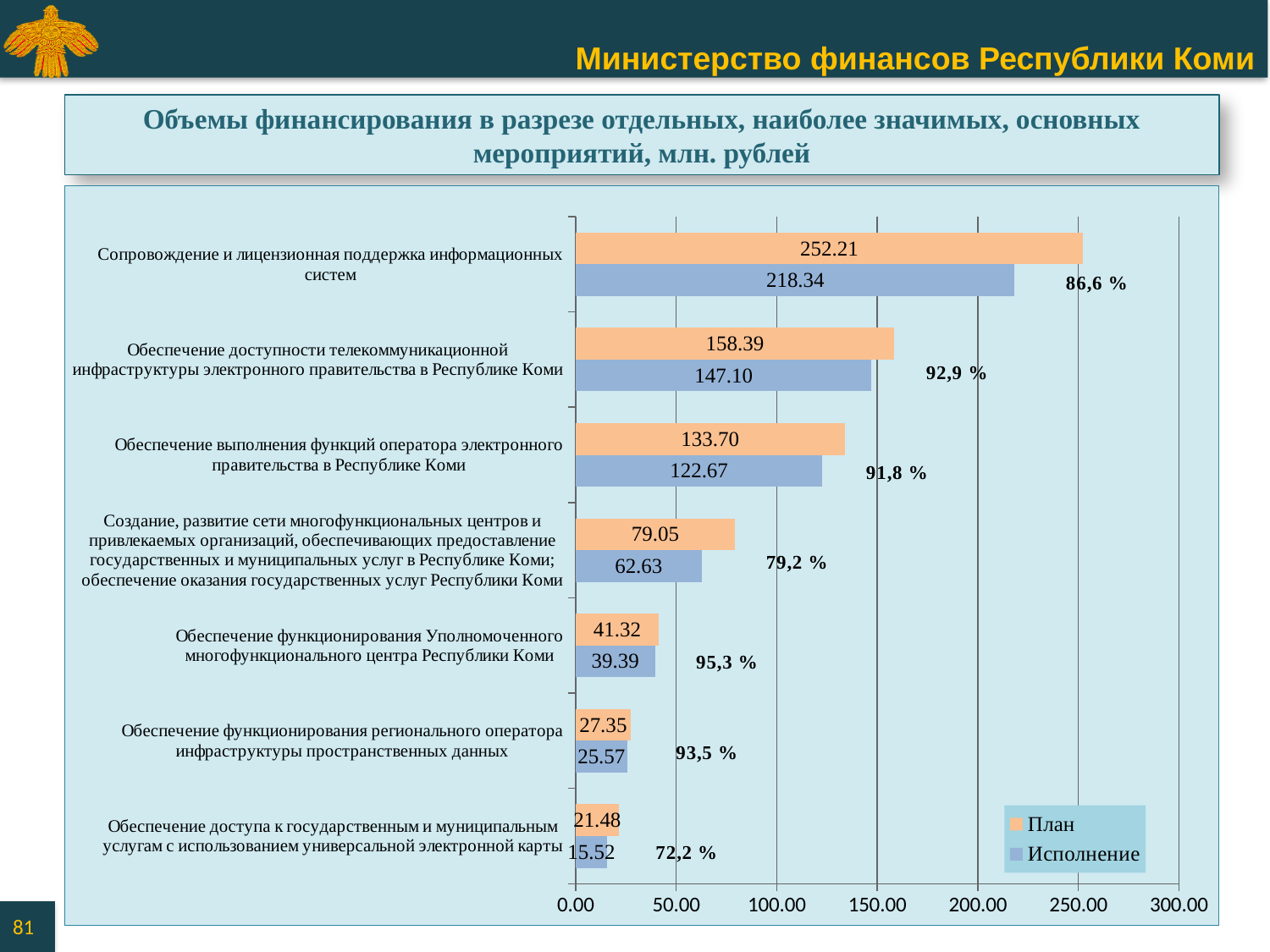
What is the Исполнение value for "Обеспечение функционирования Уполномоченного многофункционального центра Республики Коми"? 39.39 What is the План value for "Сопровождение и лицензионная поддержка информационных систем"? 252.21 What kind of chart is shown on the slide? bar chart Which category has the lowest Исполнение value? Обеспечение доступа к государственным и муниципальным услугам с использованием универсальной электронной карты Which is larger: the План value for "Обеспечение функционирования регионального оператора инфраструктуры пространственных данных" or the Исполнение value for "Обеспечение функционирования Уполномоченного многофункционального центра Республики Коми"? Исполнение value for Обеспечение функционирования Уполномоченного многофункционального центра Республики Коми (39.39) How many series does the legend list? 2 What is the Исполнение value for "Обеспечение доступности телекоммуникационной инфраструктуры электронного правительства в Республике Коми"? 147.10 How many categories are shown on the chart? 7 Is the Исполнение value for "Сопровождение и лицензионная поддержка информационных систем" greater or less than 200.00? greater What is the difference between the План and Исполнение values for "Обеспечение выполнения функций оператора электронного правительства в Республике Коми"? 11.03 Which category has the highest План value? Сопровождение и лицензионная поддержка информационных систем What percentage is shown next to the bars for "Создание, развитие сети многофункциональных центров и привлекаемых организаций..."? 79,2 %